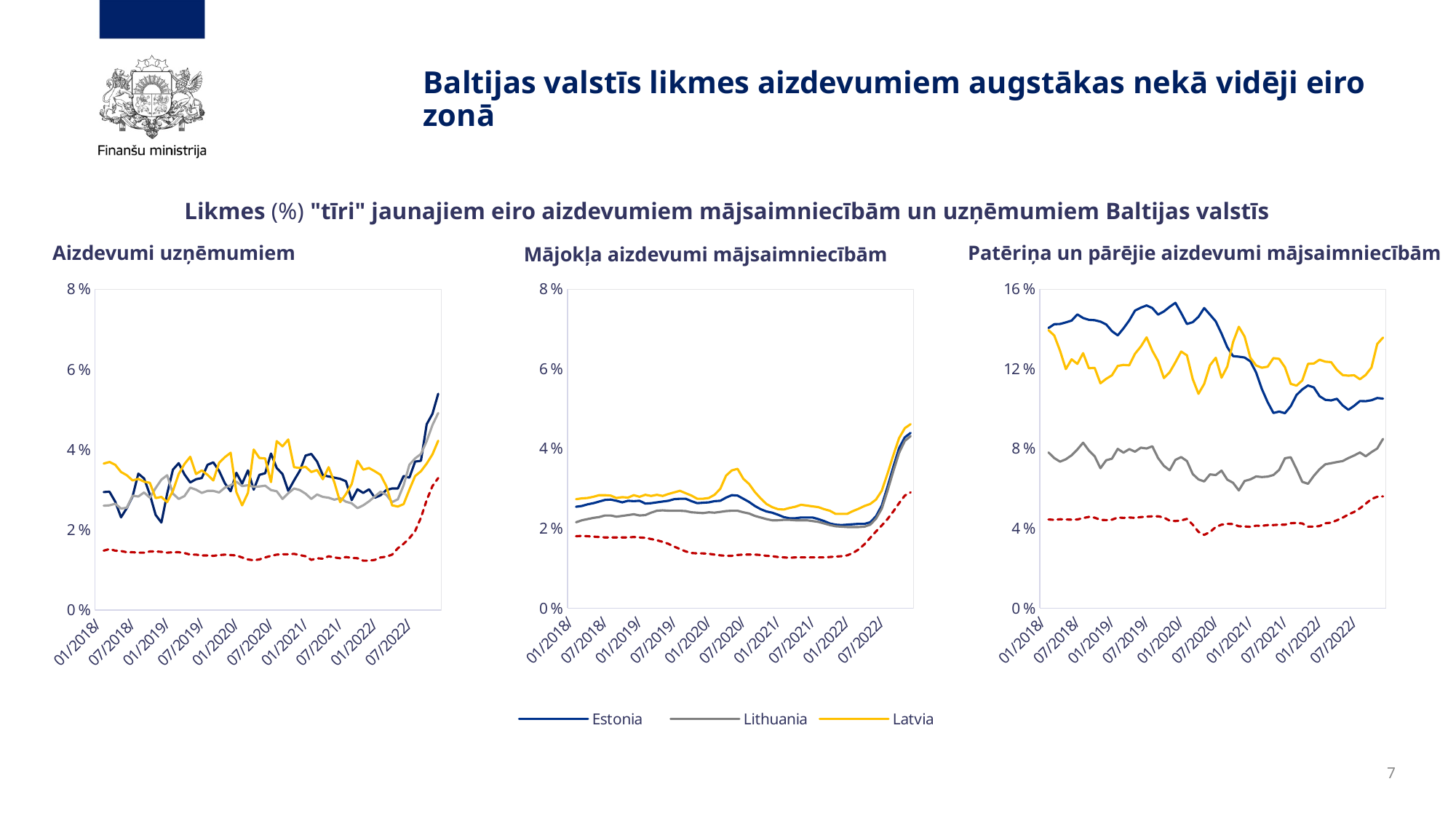
How many charts are shown on the slide? 3 In the "Patēriņa un pārējie aizdevumi mājsaimniecībām" chart, which is higher at 01/2018, Estonia or Lithuania? Estonia What kind of chart is used in the "Aizdevumi uzņēmumiem" chart? Line chart In the "Mājokļa aizdevumi mājsaimniecībām" chart, does the Estonia line rise or fall from 01/2022 to the end of the series? rise In the "Patēriņa un pārējie aizdevumi mājsaimniecībām" chart, does the Estonia line overall rise or fall from 01/2018 to 07/2022? fall In the "Aizdevumi uzņēmumiem" chart, is the last value for Estonia greater or less than 4%? greater In the "Patēriņa un pārējie aizdevumi mājsaimniecībām" chart, which of the three legend countries has the lowest value at 07/2022? Lithuania In the "Mājokļa aizdevumi mājsaimniecībām" chart, is the value of the red dashed line at 01/2018 greater or less than 2%? less In the "Patēriņa un pārējie aizdevumi mājsaimniecībām" chart, is the value for Estonia at 01/2018 greater or less than 12%? greater How many series does the shared legend below the charts list? 3 What is the highest value shown on the y axis of the "Patēriņa un pārējie aizdevumi mājsaimniecībām" chart? 16 %